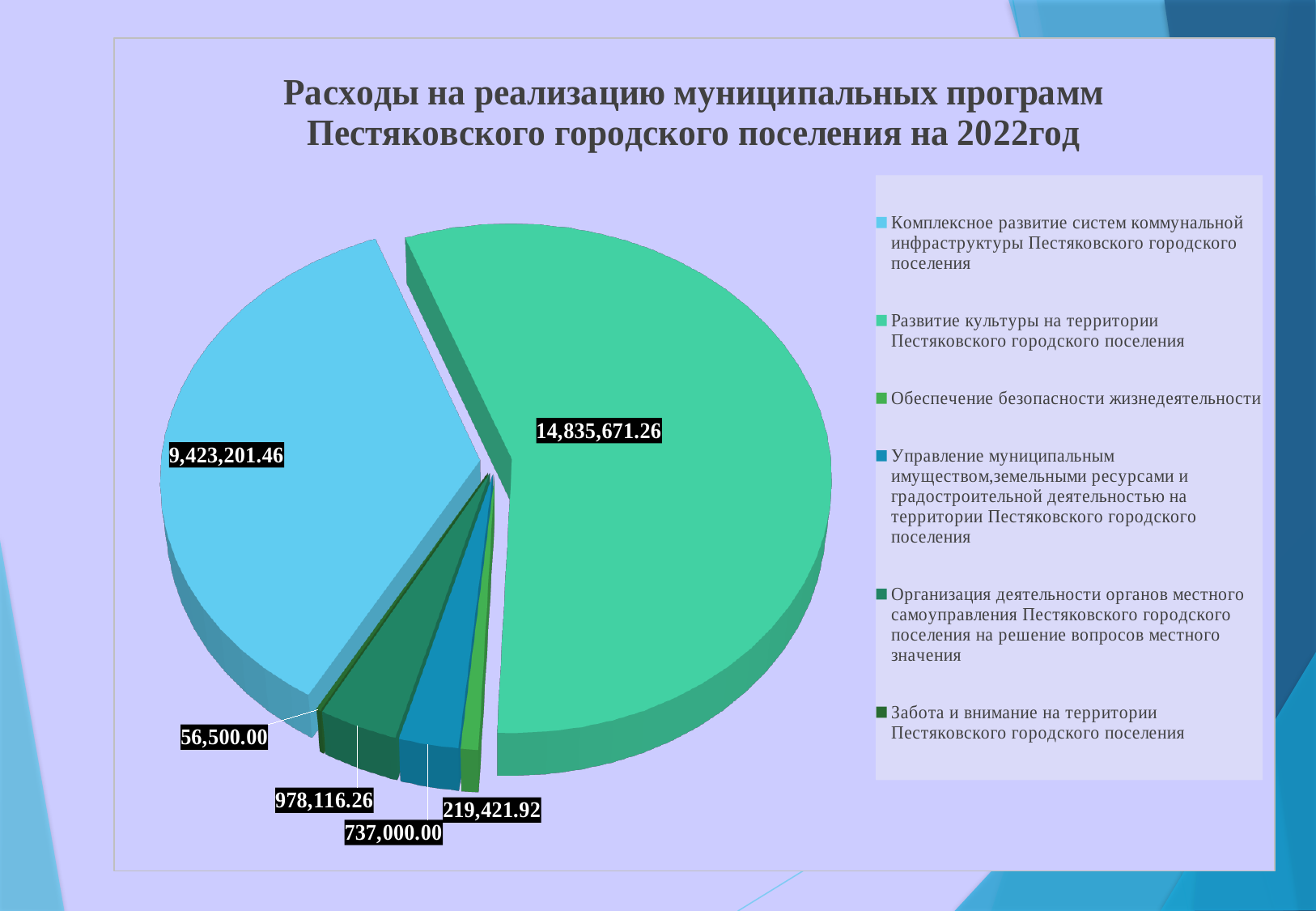
How many categories does the legend list? 6 What kind of chart is shown on the slide? Pie chart What is the difference between the value for "Организация деятельности органов местного самоуправления" and the value for "Управление муниципальным имуществом"? 241,116.26 What is the value for "Управление муниципальным имуществом, земельными ресурсами и градостроительной деятельностью на территории Пестяковского городского поселения"? 737,000.00 What is the value for "Развитие культуры на территории Пестяковского городского поселения"? 14,835,671.26 Which is larger: the value for "Обеспечение безопасности жизнедеятельности" or the value for "Управление муниципальным имуществом"? Управление муниципальным имуществом What is the difference between the value for "Развитие культуры" and the value for "Комплексное развитие систем коммунальной инфраструктуры"? 5,412,469.80 What is the title of the chart? Расходы на реализацию муниципальных программ Пестяковского городского поселения на 2022год What is the value for "Комплексное развитие систем коммунальной инфраструктуры Пестяковского городского поселения"? 9,423,201.46 Which category has the largest slice of the pie? Развитие культуры на территории Пестяковского городского поселения What is the value for "Забота и внимание на территории Пестяковского городского поселения"? 56,500.00 Which category has the smallest slice of the pie? Забота и внимание на территории Пестяковского городского поселения